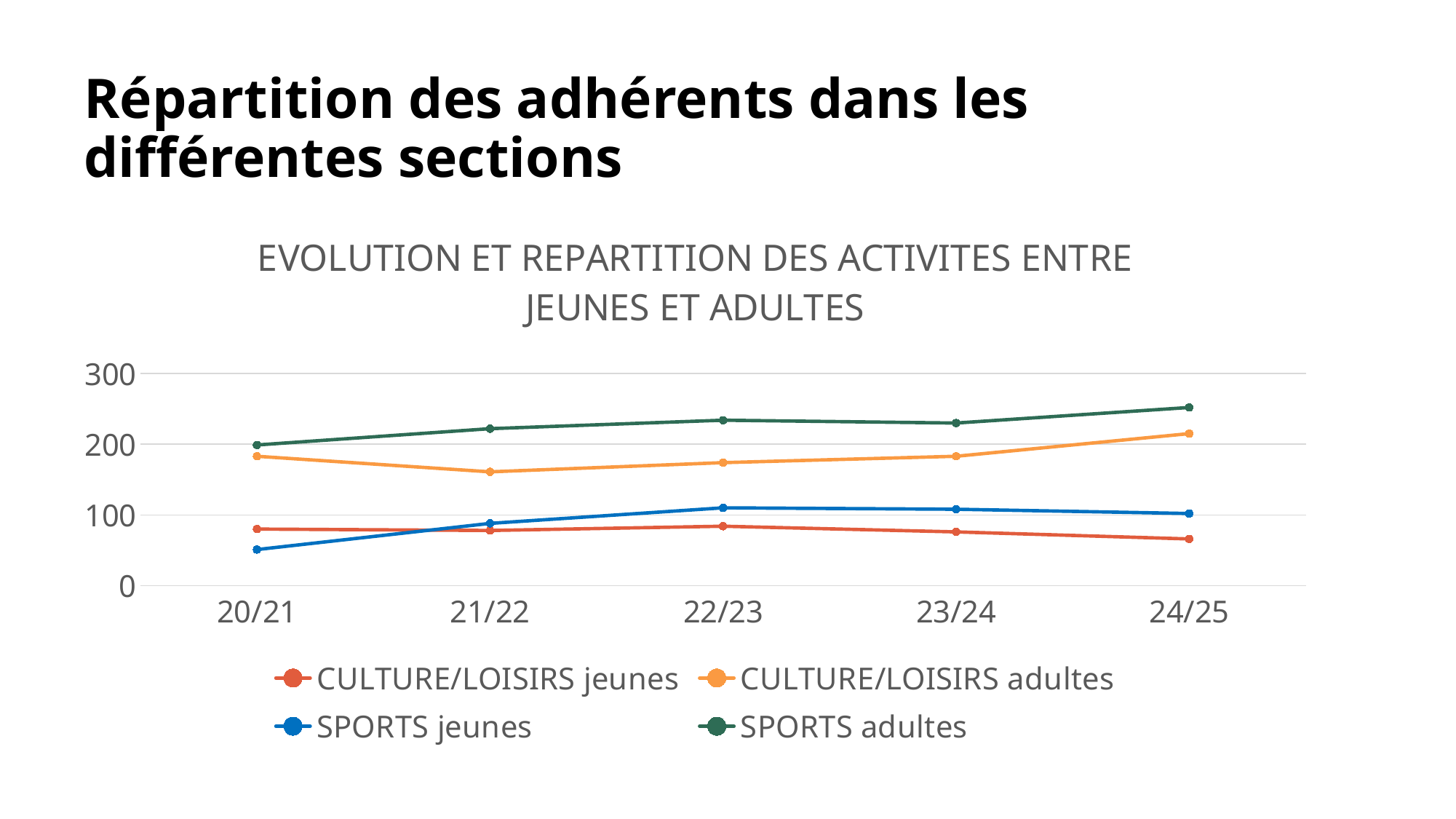
What kind of chart is shown on the slide? line chart Is the value for CULTURE/LOISIRS adultes in 21/22 greater or less than 200? less In which season is the SPORTS adultes value highest? 24/25 Which series has the highest value in 24/25? SPORTS adultes Is the value for SPORTS jeunes in 20/21 greater or less than 100? less Which series has the lowest value in 24/25? CULTURE/LOISIRS jeunes In 20/21, which is larger: CULTURE/LOISIRS jeunes or SPORTS jeunes? CULTURE/LOISIRS jeunes Does the CULTURE/LOISIRS jeunes line rise or fall from 22/23 to 24/25? fall How many series does the legend list? 4 In which season is the SPORTS jeunes value lowest? 20/21 Is the value for SPORTS adultes in 24/25 greater or less than 200? greater How many seasons are shown along the x axis? 5